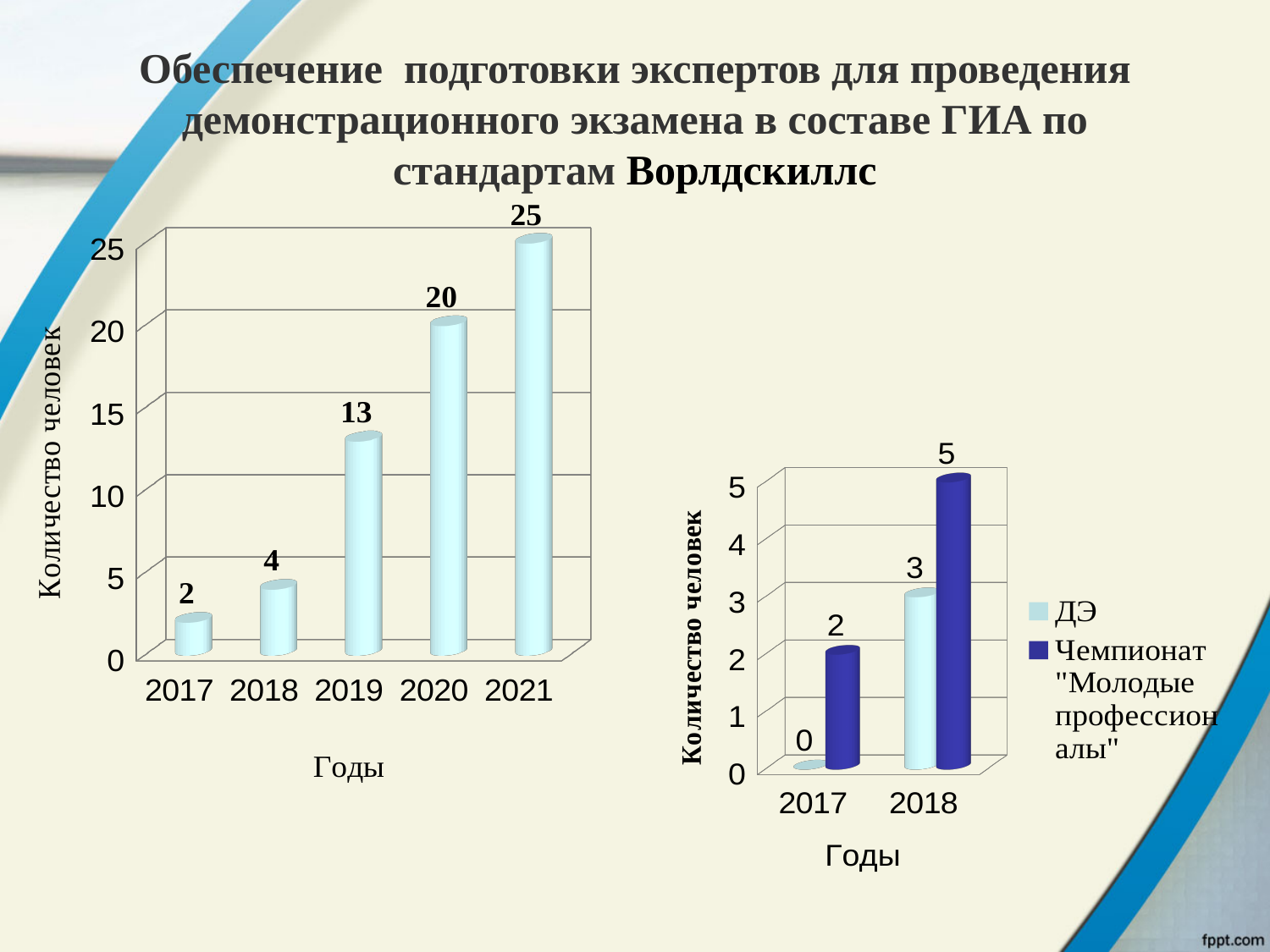
In the right chart, what is the difference between the Чемпионат "Молодые профессионалы" values for 2018 and 2017? 3 In the left chart, do the values rise or fall from 2017 to 2021? rise In the left chart, how many years are shown on the x axis? 5 In the right chart, what is the value for Чемпионат "Молодые профессионалы" in 2017? 2 In the left chart, what is the value for 2019? 13 In the right chart, how many series does the legend list? 2 In the left chart, what is the difference between the values for 2020 and 2018? 16 In the right chart, what is the value for ДЭ in 2018? 3 What kind of chart is the left chart? bar chart In the left chart, which year has the lowest value? 2017 In the right chart, which series has the larger value in 2018, ДЭ or Чемпионат "Молодые профессионалы"? Чемпионат "Молодые профессионалы" In the left chart, what is the value for 2021? 25